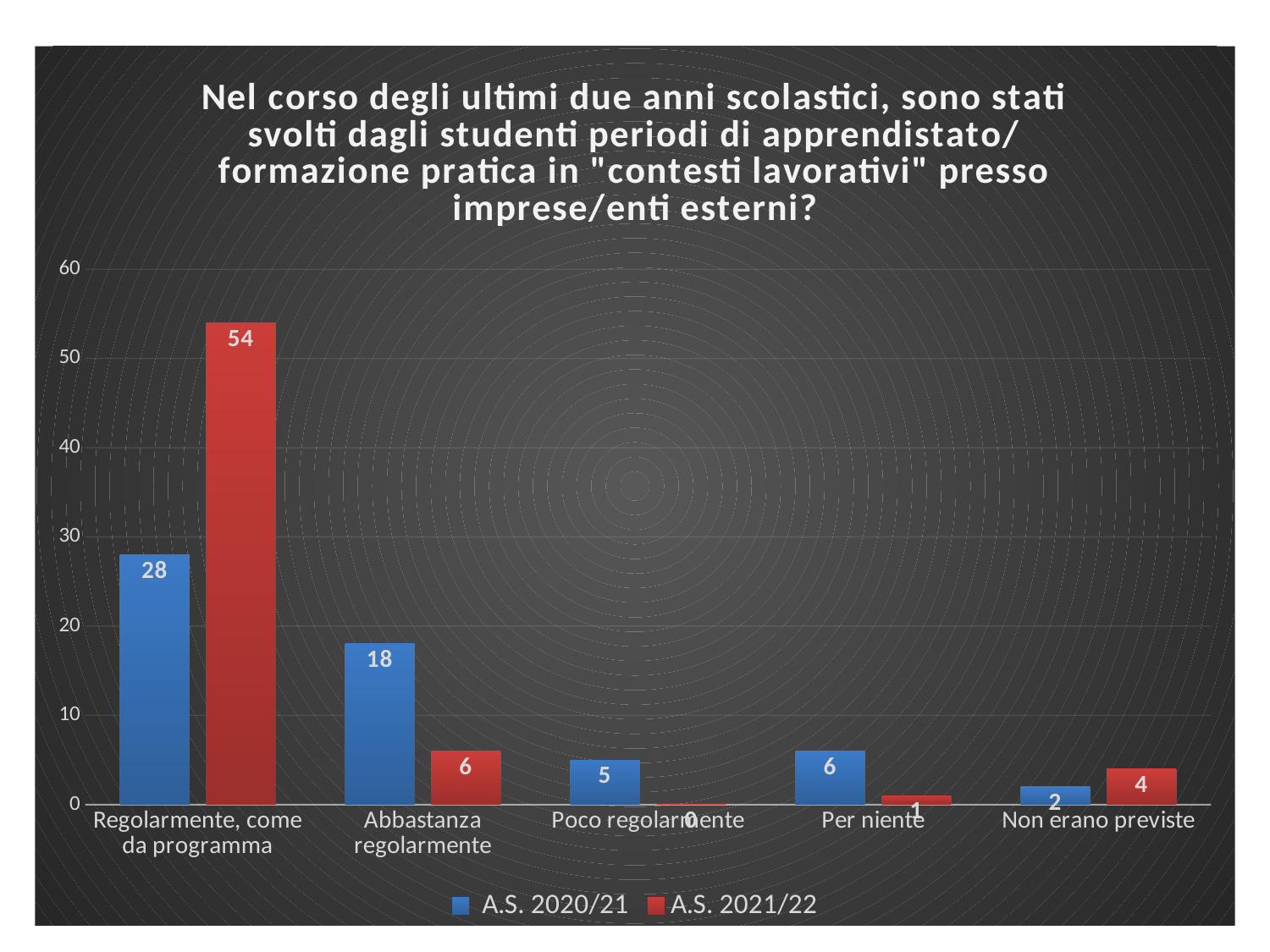
What is the difference between the A.S. 2021/22 and A.S. 2020/21 values for "Regolarmente, come da programma"? 26 How many series does the legend list? 2 Which is larger for "Abbastanza regolarmente": the A.S. 2020/21 value or the A.S. 2021/22 value? A.S. 2020/21 What kind of chart is shown on the slide? bar chart What is the value for "Abbastanza regolarmente" in the A.S. 2020/21 series? 18 Which category has the lowest value in the A.S. 2020/21 series? Non erano previste Which series is shown in red in the legend? A.S. 2021/22 What is the value for "Non erano previste" in the A.S. 2020/21 series? 2 Which category has the highest value in the A.S. 2021/22 series? Regolarmente, come da programma How many categories are shown on the x axis? 5 What is the value for "Regolarmente, come da programma" in the A.S. 2021/22 series? 54 What is the value for "Per niente" in the A.S. 2021/22 series? 1